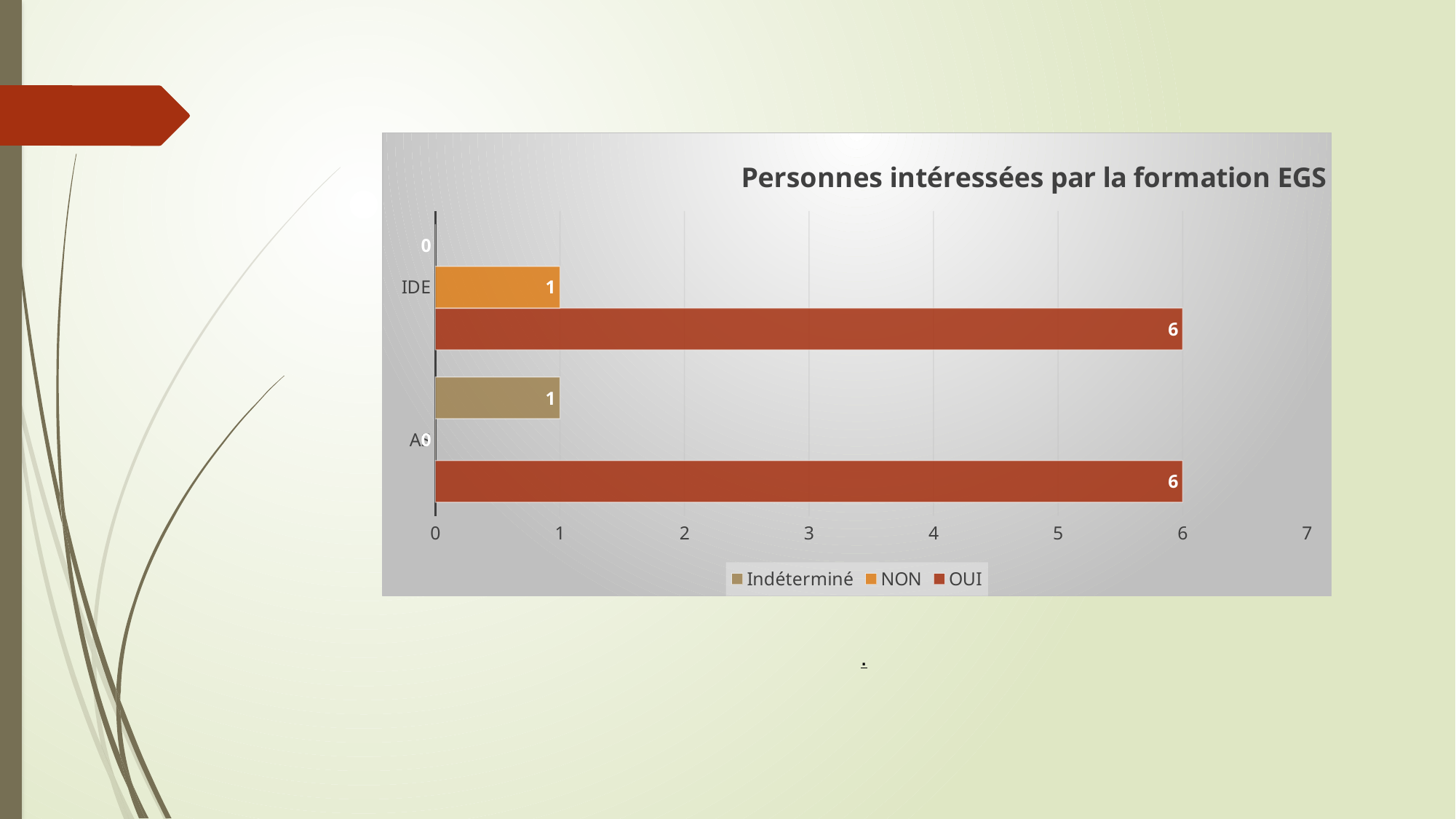
What is the OUI value for IDE? 6 What type of chart is shown on the slide? bar chart How many series does the legend list? 3 Which series are listed in the legend? Indéterminé, NON, OUI What is the OUI value for the lower category on the chart? 6 What is the difference between the OUI and NON values for IDE? 5 What is the Indéterminé value for IDE? 0 What is the title of the chart? Personnes intéressées par la formation EGS Which series has the highest value for IDE? OUI Is the OUI value for IDE greater or less than 4? greater For IDE, which is larger: the NON value or the OUI value? OUI What is the NON value for IDE? 1